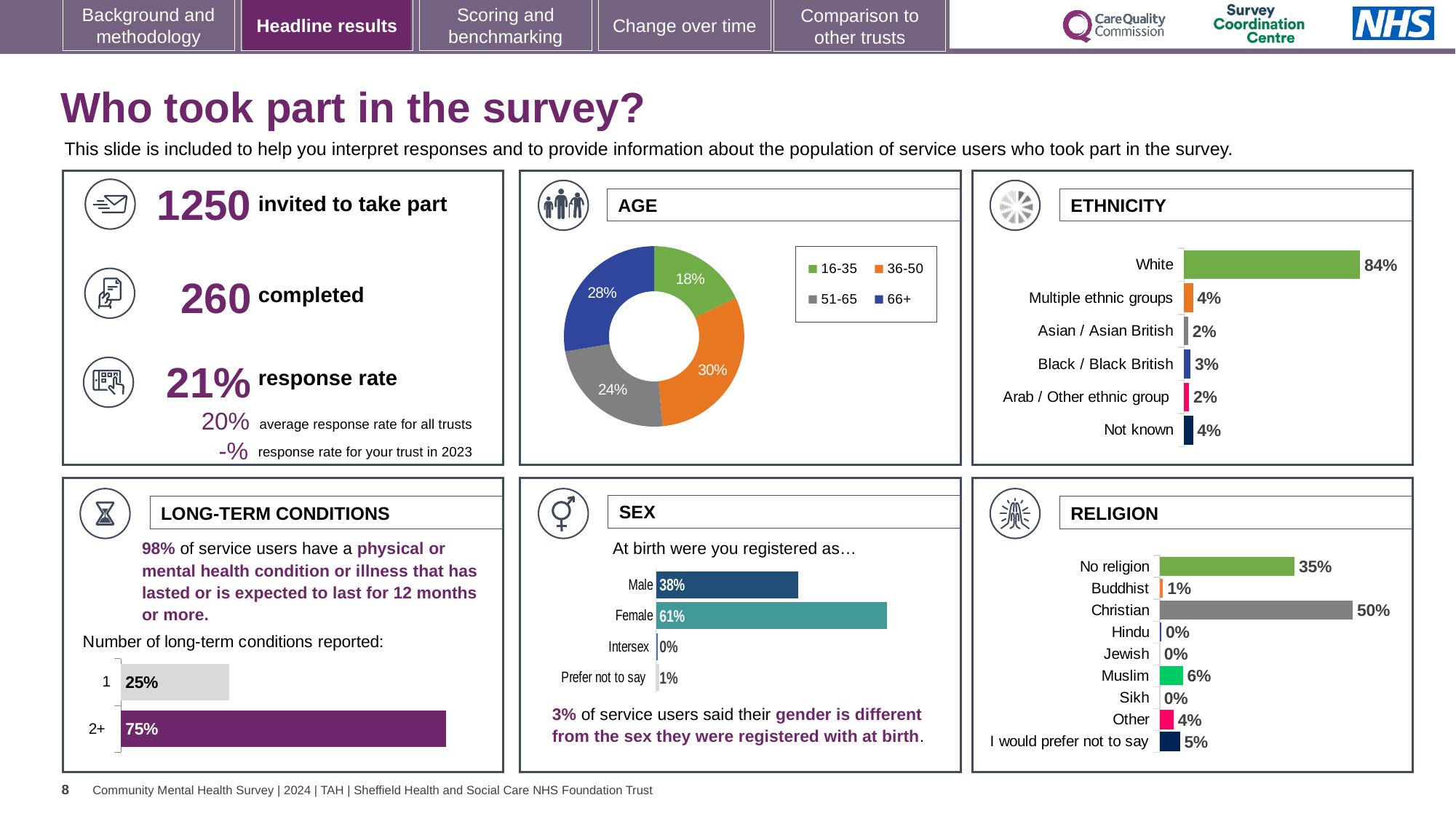
In the ETHNICITY chart, how many categories are shown? 6 In the RELIGION chart, which category has the highest value? Christian In the AGE chart, which age group has the smallest share? 16-35 In the LONG-TERM CONDITIONS chart, what percentage reported 2+ conditions? 75% In the SEX chart, what is the value for Prefer not to say? 1% In the AGE chart, what percentage of respondents were aged 36-50? 30% In the ETHNICITY chart, what is the value for White? 84% In the RELIGION chart, what is the difference between Christian and No religion? 15% What kind of chart is the AGE chart? Doughnut chart How many entries does the legend of the AGE chart list? 4 In the SEX chart, which is larger, Male or Female? Female In the ETHNICITY chart, what is the difference between Multiple ethnic groups and Asian / Asian British? 2%